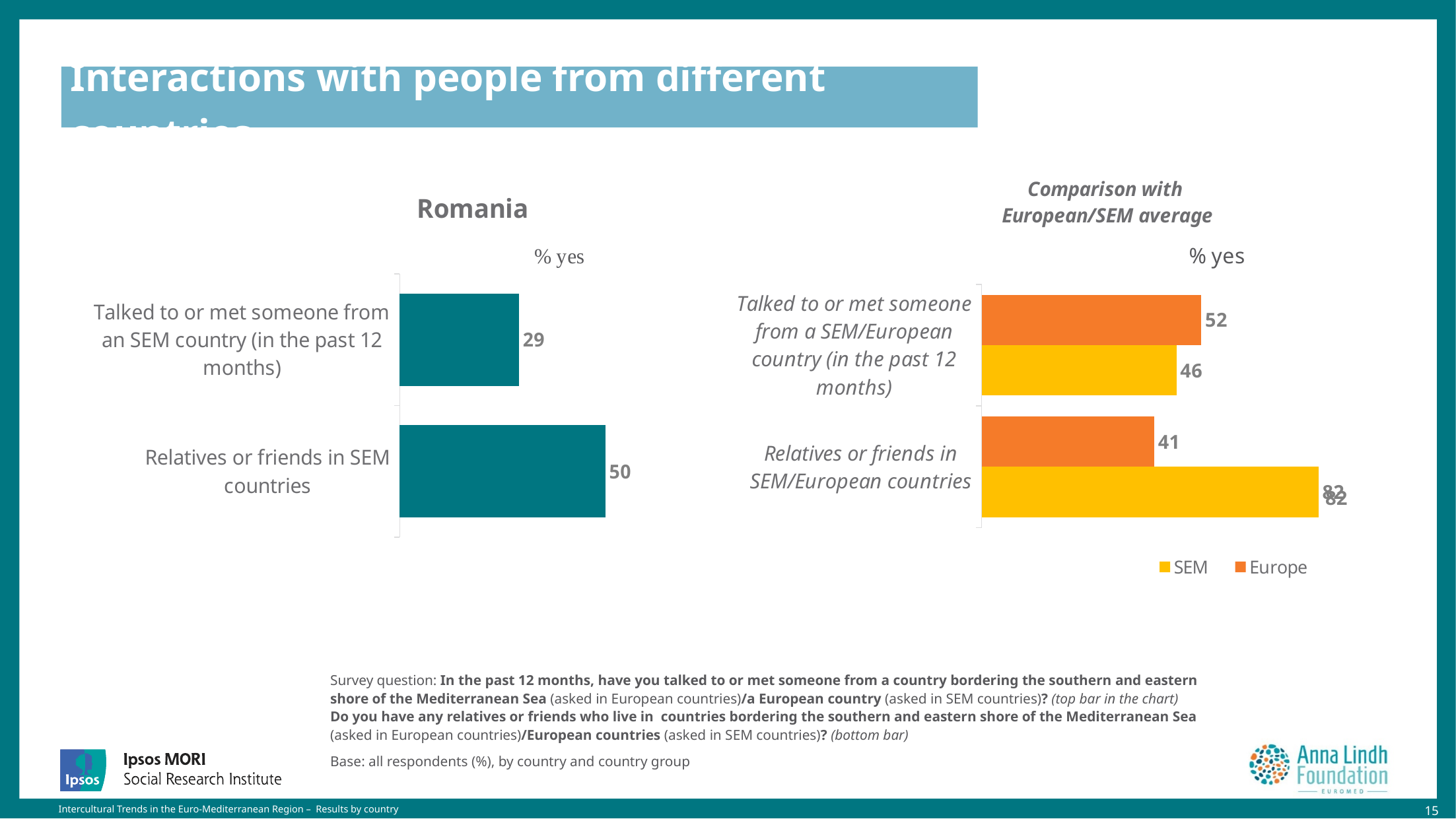
In the Romania chart, what is the difference between the value for 'Relatives or friends in SEM countries' and the value for 'Talked to or met someone from an SEM country'? 21 How many categories does the Romania chart show? 2 In the Romania chart, which category has the higher value? Relatives or friends in SEM countries In the 'Comparison with European/SEM average' chart, what is the SEM value for 'Talked to or met someone from a SEM/European country (in the past 12 months)'? 46 In the 'Comparison with European/SEM average' chart, what is the Europe value for 'Relatives or friends in SEM/European countries'? 41 How many series does the legend of the 'Comparison with European/SEM average' chart list? 2 In the 'Comparison with European/SEM average' chart, what is the Europe value for 'Talked to or met someone from a SEM/European country (in the past 12 months)'? 52 In the Romania chart, what is the value for 'Relatives or friends in SEM countries'? 50 In the 'Comparison with European/SEM average' chart, for 'Talked to or met someone from a SEM/European country', which is larger: the Europe value or the SEM value? Europe In the 'Comparison with European/SEM average' chart, what is the difference between the Europe and SEM values for 'Talked to or met someone from a SEM/European country'? 6 In the Romania chart, what is the value for 'Talked to or met someone from an SEM country (in the past 12 months)'? 29 What kind of chart is the Romania chart? Bar chart